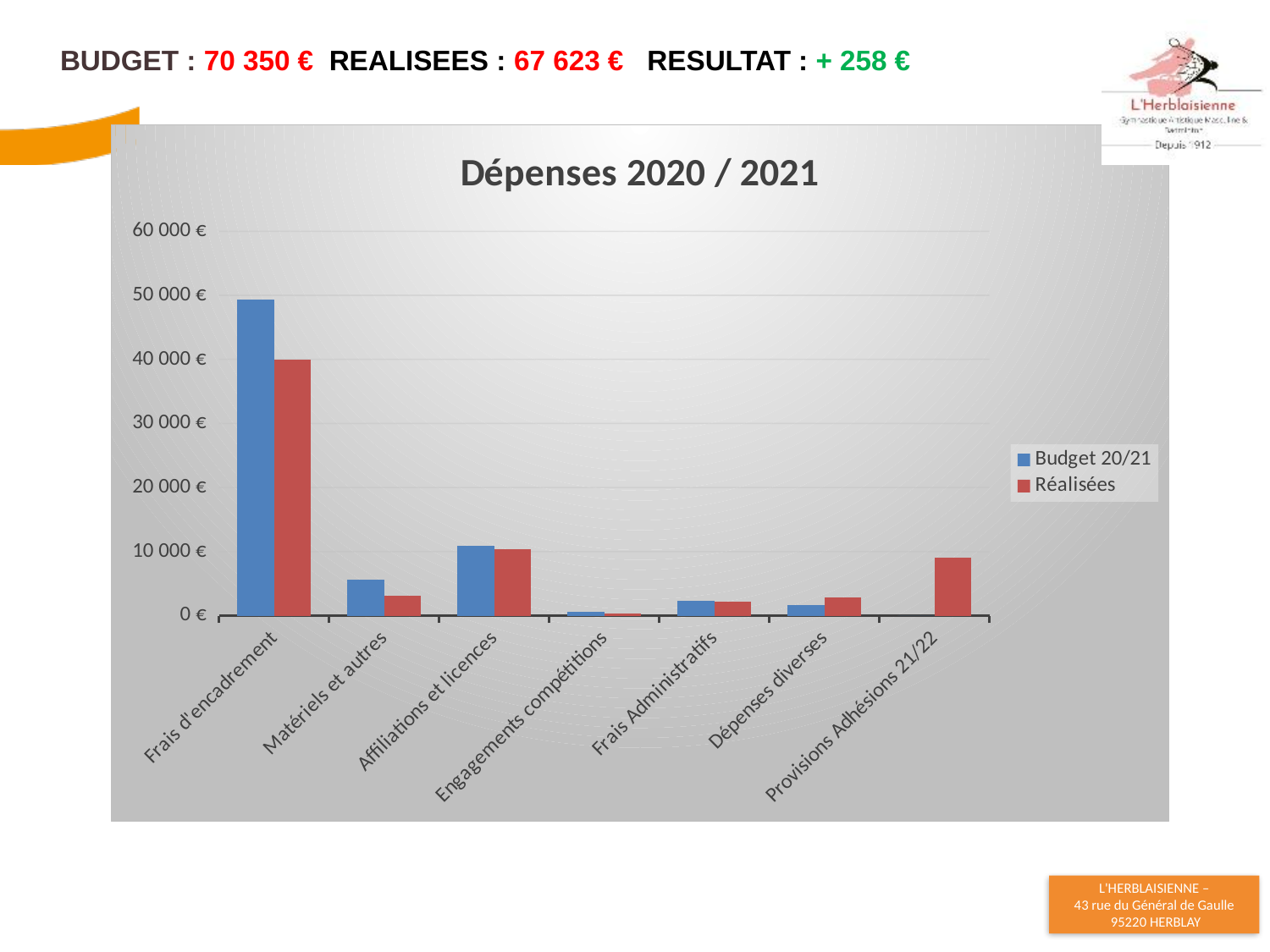
What kind of chart is shown on the slide? bar chart How many categories are shown on the x axis of the chart? 7 For Provisions Adhésions 21/22, which is larger: the Budget 20/21 value or the Réalisées value? Réalisées For Frais d'encadrement, which is larger: the Budget 20/21 value or the Réalisées value? Budget 20/21 Which colour represents the Réalisées series in the chart? red Which category has the highest Budget 20/21 value? Frais d'encadrement Is the Budget 20/21 value for Frais d'encadrement greater or less than 40 000 €? greater Which category has the highest Réalisées value? Frais d'encadrement Is the Réalisées value for Provisions Adhésions 21/22 greater or less than 10 000 €? less Is the Réalisées value for Frais d'encadrement greater or less than 50 000 €? less What is the title of the chart? Dépenses 2020 / 2021 How many series does the chart legend list? 2